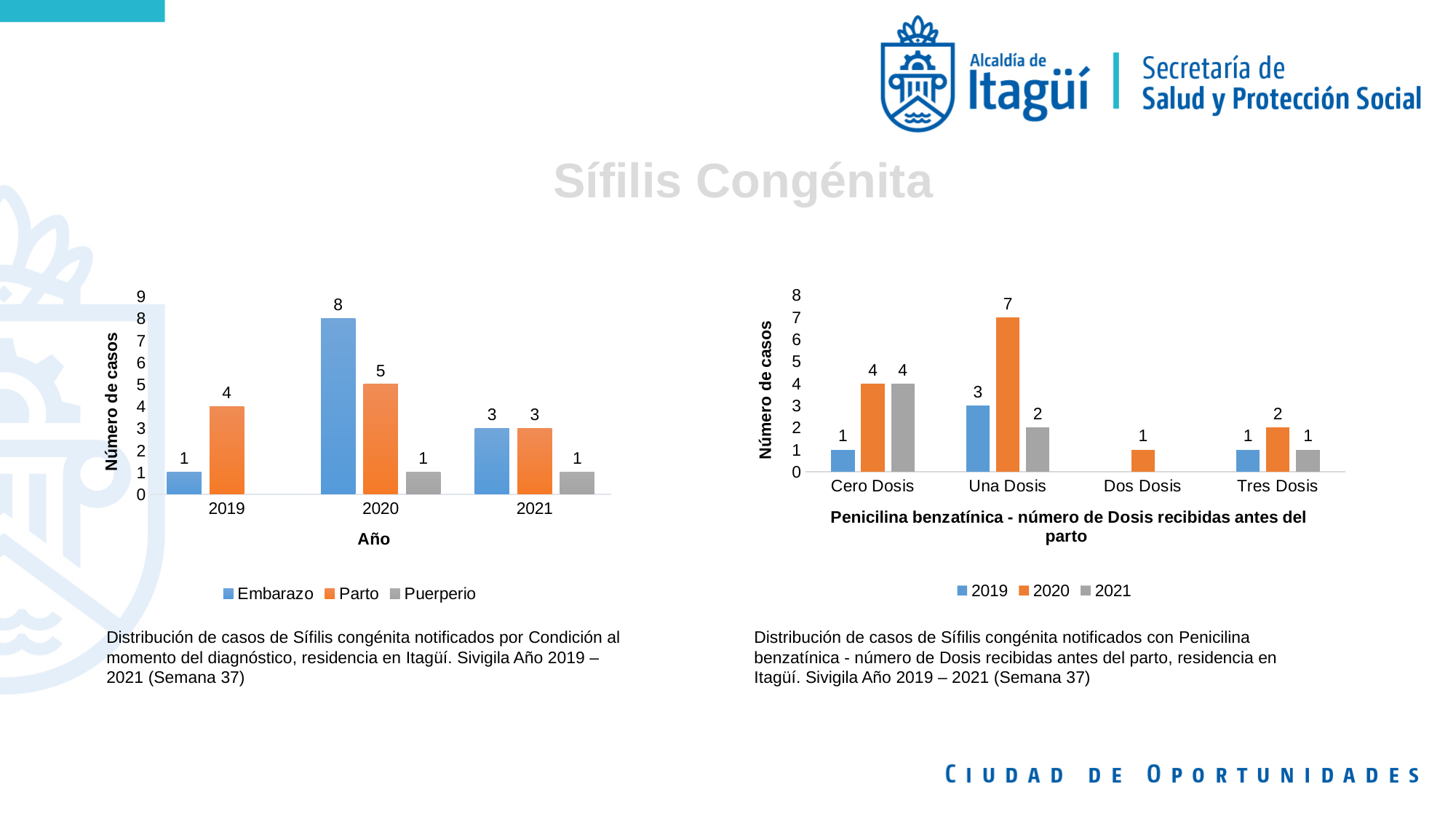
In the left chart (casos por Condición al momento del diagnóstico), how many series does the legend list? 3 In the left chart (casos por Condición al momento del diagnóstico), what is the value for Parto in 2019? 4 In the left chart (casos por Condición al momento del diagnóstico), what is the total of all three series in 2021? 7 In the right chart (Penicilina benzatínica - número de Dosis), what is the value for 2021 at Cero Dosis? 4 In the right chart (Penicilina benzatínica - número de Dosis), which dose category has the highest 2020 value? Una Dosis In the left chart (casos por Condición al momento del diagnóstico), what is the difference between Embarazo and Parto in 2020? 3 In the right chart (Penicilina benzatínica - número de Dosis), is the 2019 value at Una Dosis larger or smaller than the 2021 value at Una Dosis? larger In the right chart (Penicilina benzatínica - número de Dosis), what is the value for 2020 at Una Dosis? 7 In the left chart (casos por Condición al momento del diagnóstico), what is the value for Embarazo in 2020? 8 What kind of chart is the right chart (Penicilina benzatínica - número de Dosis)? bar chart In the left chart (casos por Condición al momento del diagnóstico), which year has the highest Embarazo value? 2020 In the right chart (Penicilina benzatínica - número de Dosis), how many dose categories are shown on the x axis? 4